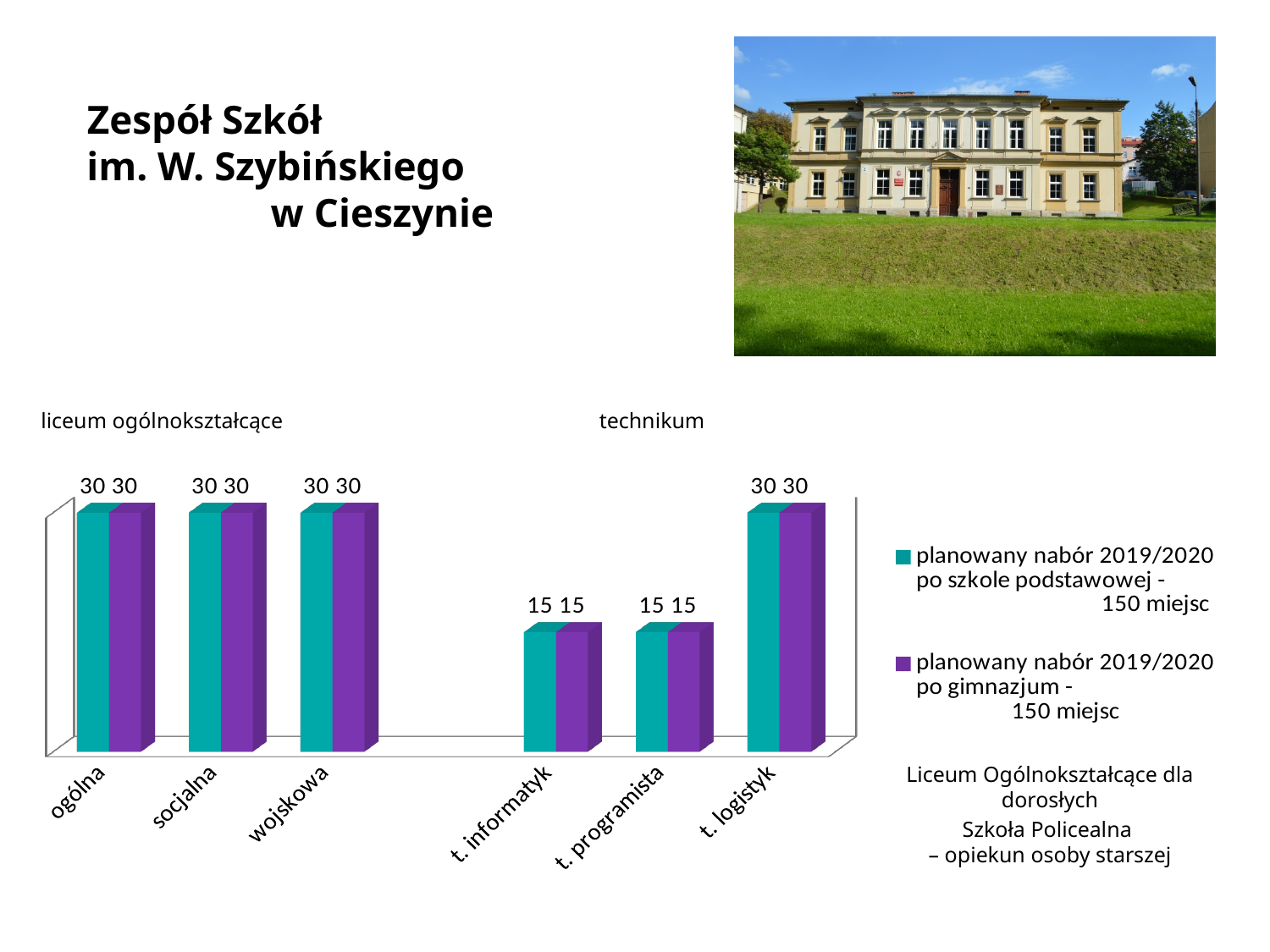
Which category has the lowest value in the 'planowany nabór 2019/2020 po szkole podstawowej' series: 'ogólna' or 't. programista'? t. programista What is the difference between the 'planowany nabór 2019/2020 po gimnazjum' values for 'socjalna' and 't. informatyk'? 15 What kind of chart is shown on the slide? bar chart Which is larger: the 'planowany nabór 2019/2020 po szkole podstawowej' value for 't. logistyk' or for 't. informatyk'? t. logistyk How many series does the chart's legend list? 2 What is the value for 't. logistyk' in the 'planowany nabór 2019/2020 po szkole podstawowej' series? 30 How many categories are shown on the x axis of the chart? 6 What is the value for 't. informatyk' in the 'planowany nabór 2019/2020 po szkole podstawowej' series? 15 What is the value for 't. programista' in the 'planowany nabór 2019/2020 po gimnazjum' series? 15 What is the value for 'wojskowa' in the 'planowany nabór 2019/2020 po gimnazjum' series? 30 Which colour represents the 'planowany nabór 2019/2020 po gimnazjum' series in the chart? purple What is the total of the two series values for 'ogólna'? 60